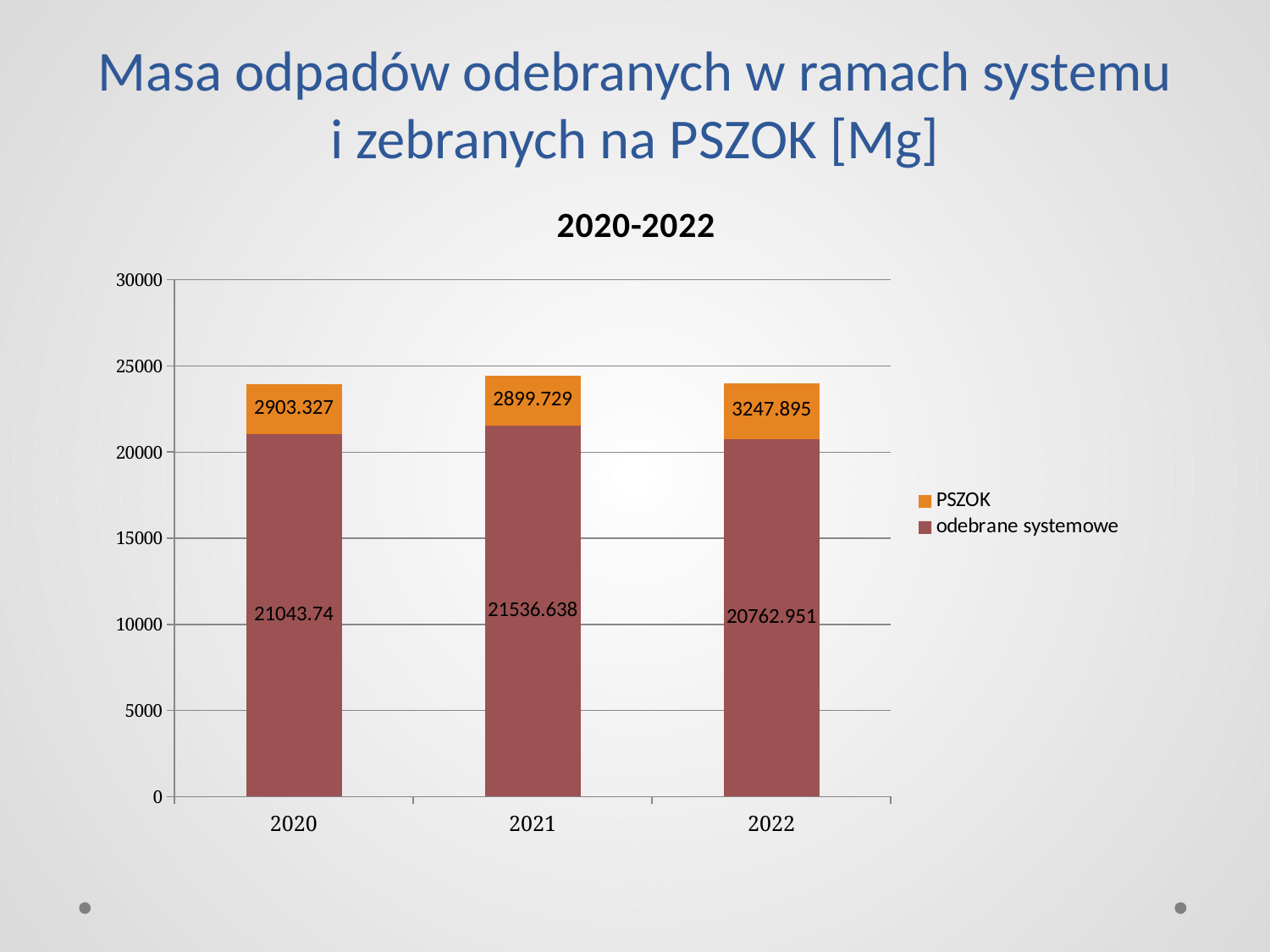
What kind of chart is shown on the slide? Stacked bar chart What is the PSZOK value for 2020? 2903.327 What is the total of the stacked bar for 2021? 24436.367 Which year has the highest PSZOK value? 2022 Is the odebrane systemowe value for 2021 larger than the odebrane systemowe value for 2022? Yes How many years are shown on the x axis? 3 What is the difference between the PSZOK values for 2022 and 2020? 344.568 Which year has the highest odebrane systemowe value? 2021 What is the PSZOK value for 2022? 3247.895 Which year has the lowest odebrane systemowe value? 2022 How many series does the legend list? 2 What is the odebrane systemowe value for 2022? 20762.951